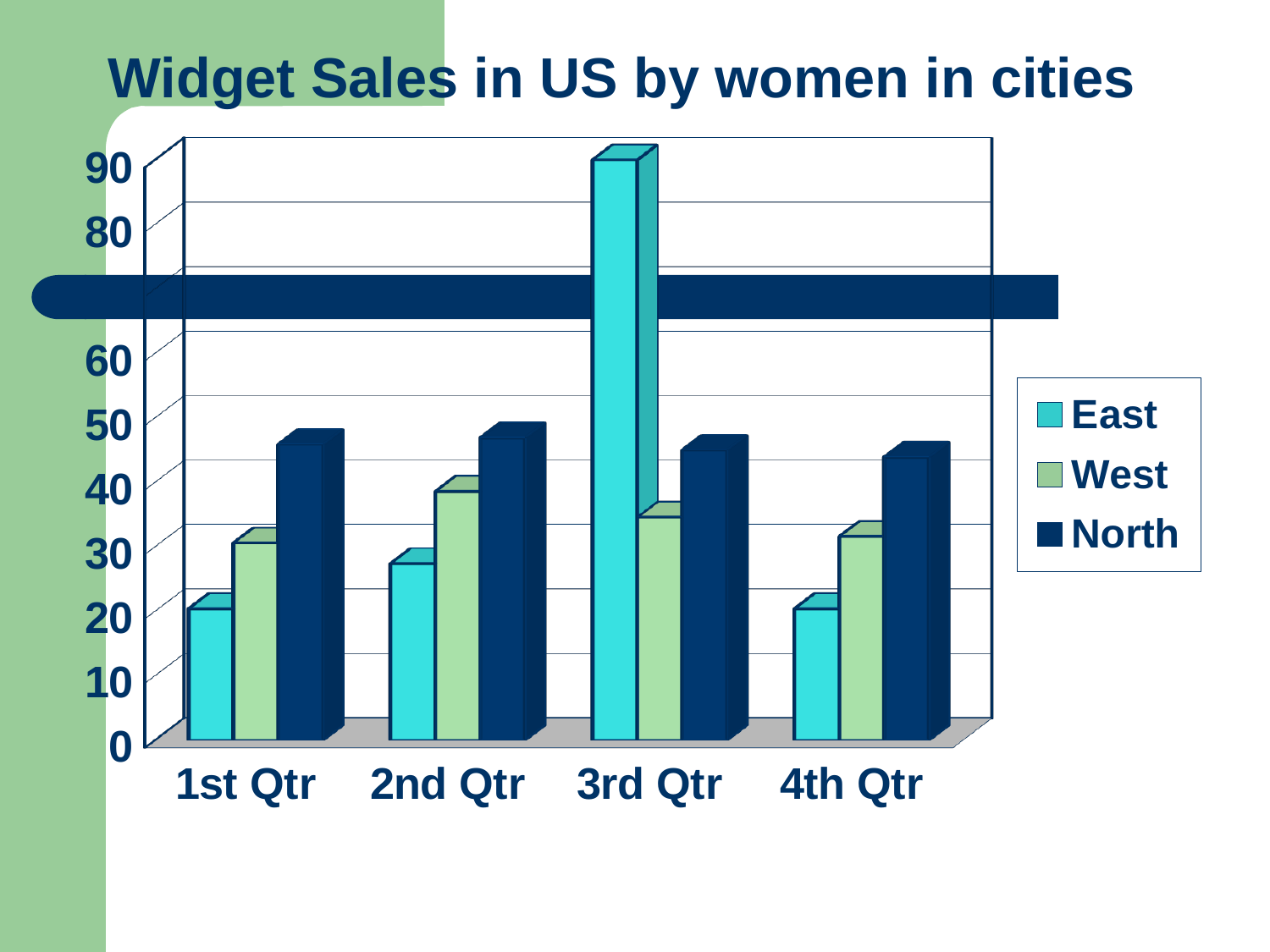
What is the title of the slide? Widget Sales in US by women in cities Is the East value for 3rd Qtr greater or less than 80? greater Which series is shown in the darkest blue colour? North Which quarter has the highest East value? 3rd Qtr In 3rd Qtr, which is larger, the East value or the West value? East In 1st Qtr, which is larger, the North value or the East value? North How many quarters are shown on the x axis? 4 Is the East value for 1st Qtr greater or less than 30? less How many series does the legend list? 3 What kind of chart is shown on the slide? bar chart Which quarter has the highest West value? 2nd Qtr Is the North value for 1st Qtr greater or less than 40? greater